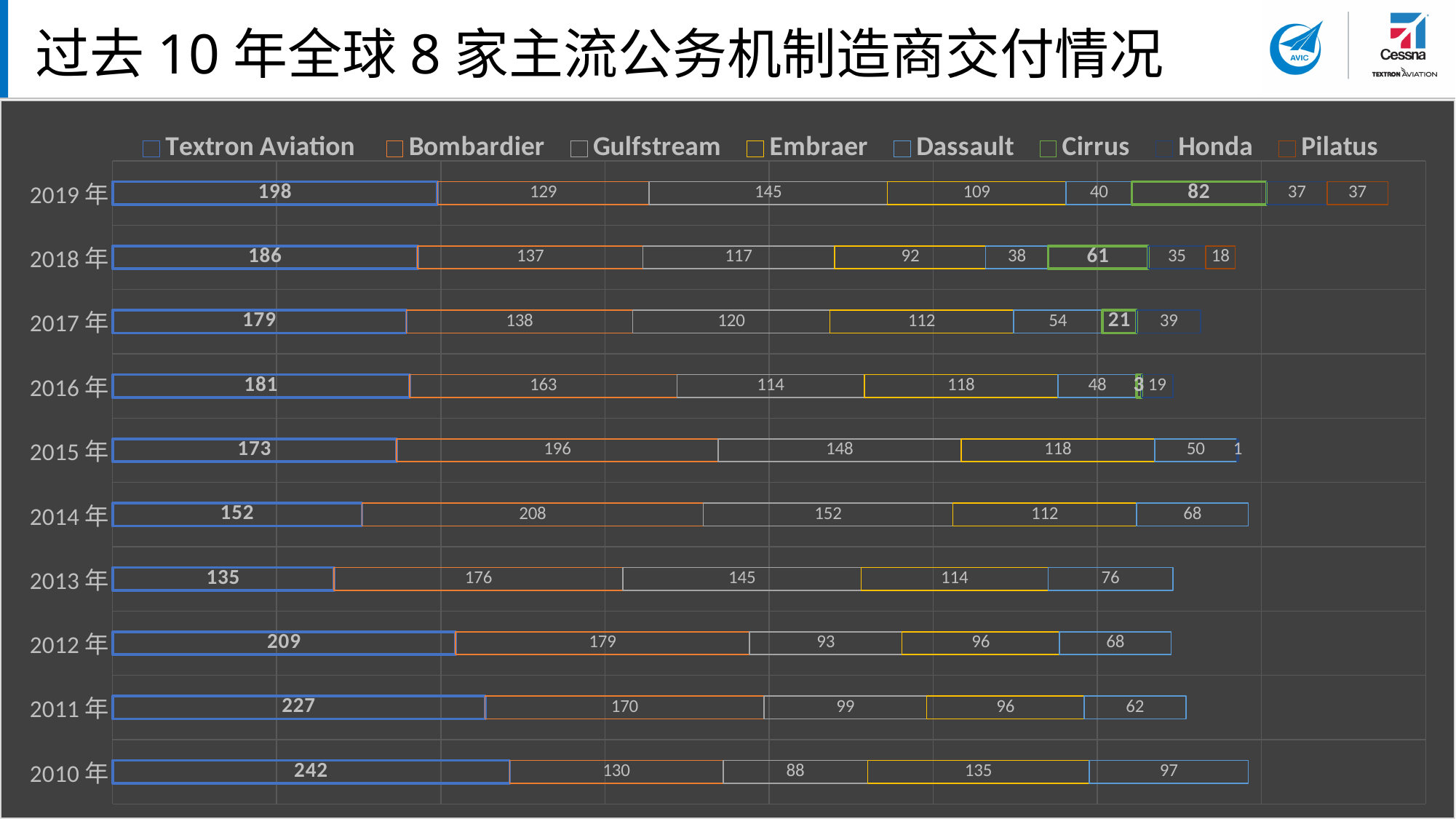
In which year was the Textron Aviation value highest? 2010 What is the difference between the Textron Aviation values for 2019 and 2018? 12 How many business jets did Textron Aviation deliver in 2019 according to the chart? 198 How many series does the legend list? 8 Do the Cirrus values rise or fall from 2016 to 2019? Rise What kind of chart is shown on the slide? Stacked bar chart How many years are shown on the chart? 10 In which year was the Textron Aviation value lowest? 2013 In 2015, which is larger: the Bombardier value or the Gulfstream value? Bombardier What is the total of the stacked bar for 2019? 777 What is the Cirrus value for 2018? 61 What is the Bombardier value for 2014? 208